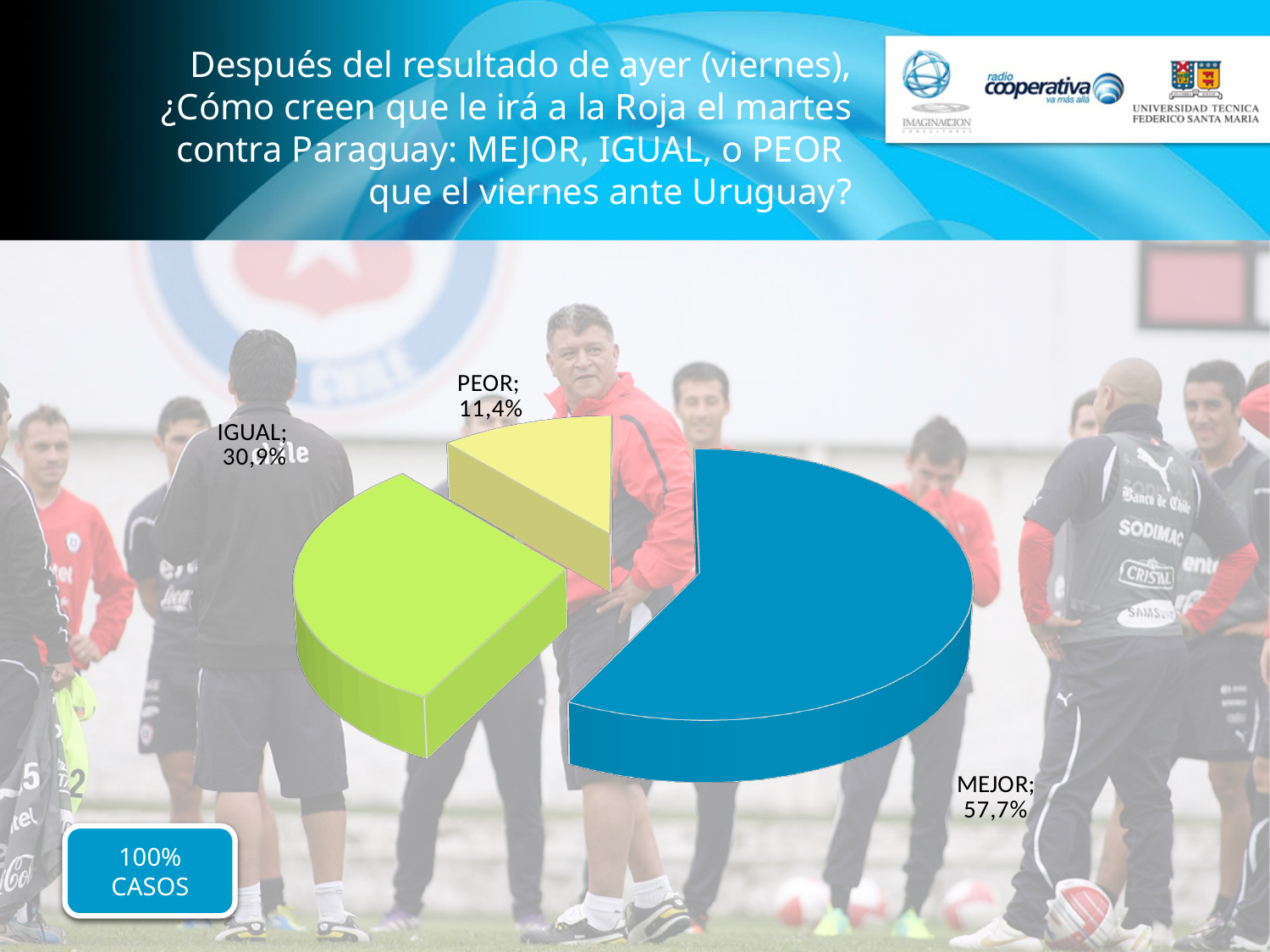
How many slices does the pie chart have? 3 What is the difference between the MEJOR and IGUAL shares? 26,8% What is the value for PEOR? 11,4% Which is larger, the share for IGUAL or the share for PEOR? IGUAL What is the value for IGUAL? 30,9% What kind of chart is shown on the slide? pie chart Which category has the largest share of the pie? MEJOR What is the value for MEJOR? 57,7% What colour is the MEJOR slice? blue What colour is the IGUAL slice? green What is the difference between the IGUAL and PEOR shares? 19,5% Which category has the smallest share of the pie? PEOR